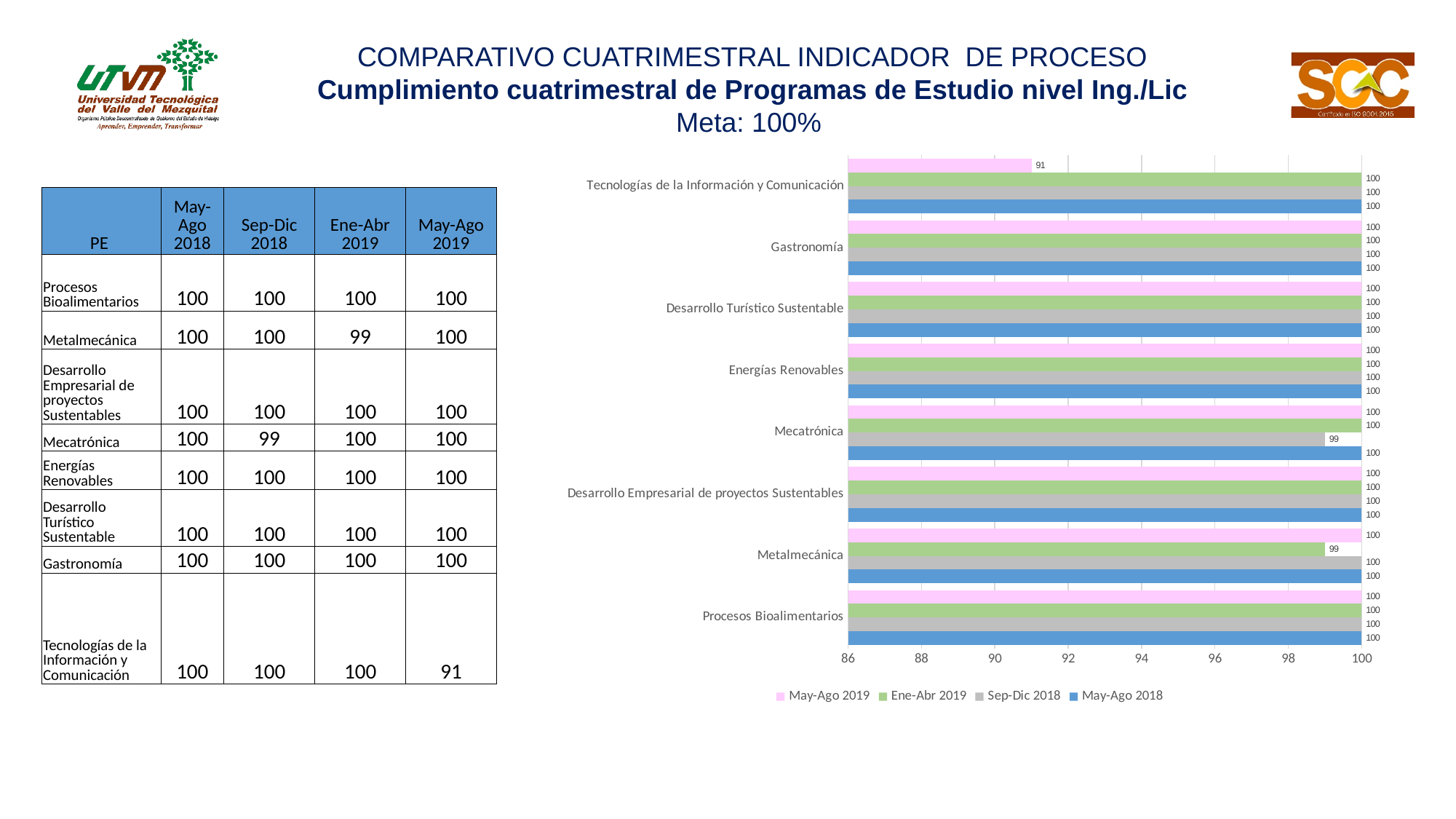
What is the Sep-Dic 2018 value for Mecatrónica in the chart? 99 What colour represents the May-Ago 2019 series in the chart's legend? pink What is the difference between the May-Ago 2018 and May-Ago 2019 values for Tecnologías de la Información y Comunicación? 9 Which program has the lowest May-Ago 2019 value in the chart? Tecnologías de la Información y Comunicación What is the May-Ago 2019 value for Gastronomía in the chart? 100 How many programs (categories) are plotted on the chart? 8 What is the May-Ago 2019 value for Tecnologías de la Información y Comunicación in the chart? 91 What kind of chart is shown on the slide? bar chart Is the May-Ago 2019 value for Tecnologías de la Información y Comunicación greater or less than 92? less What is the Ene-Abr 2019 value for Metalmecánica in the chart? 99 For Metalmecánica, which is larger: the Sep-Dic 2018 value or the Ene-Abr 2019 value? Sep-Dic 2018 How many series does the chart's legend list? 4